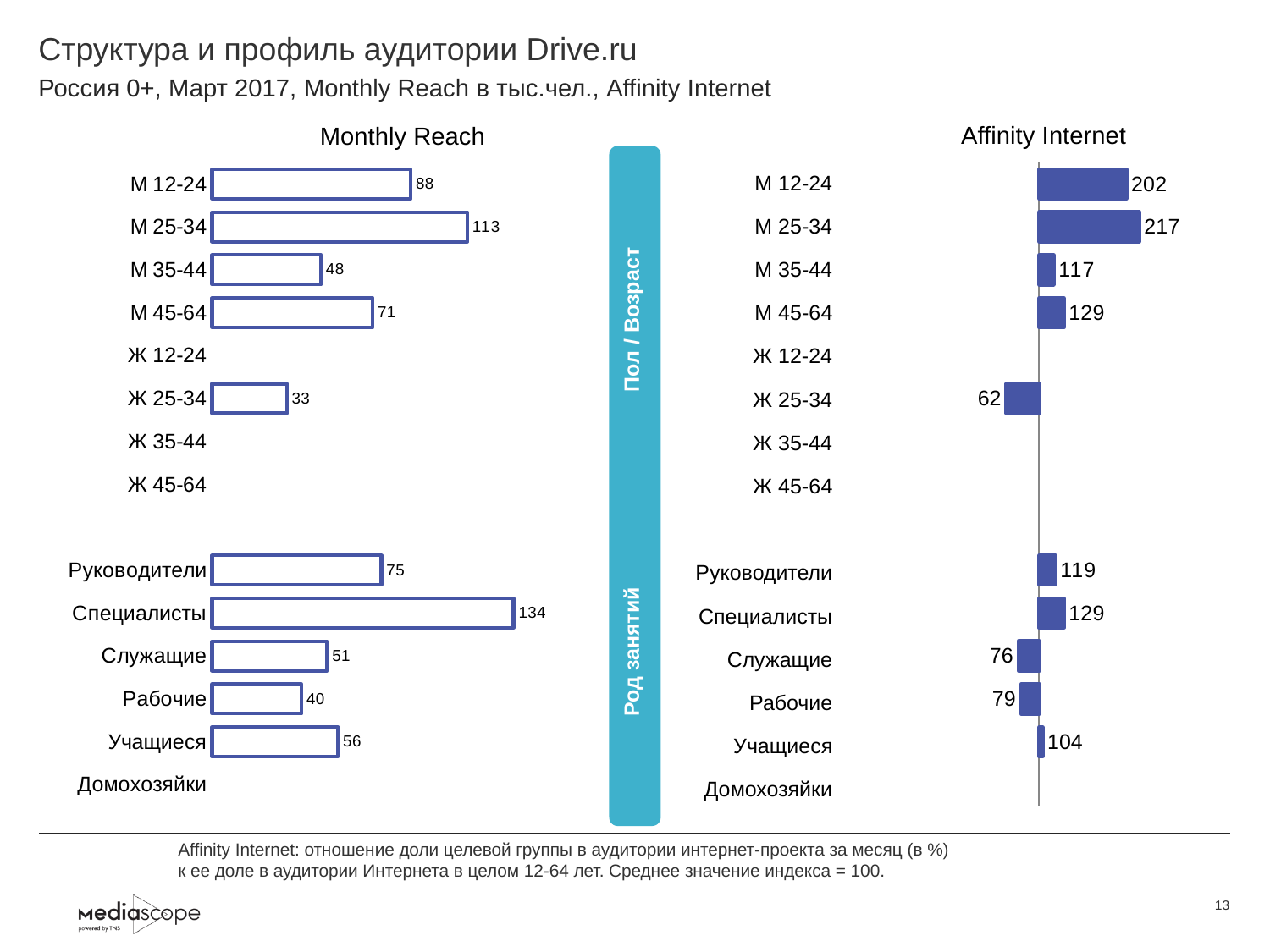
In the Affinity Internet chart, what is the value for Учащиеся? 104 In the Monthly Reach chart, what is the value for M 25-34? 113 In the Affinity Internet chart, which category has the highest value? M 25-34 In the Monthly Reach chart, which is larger: the value for Руководители or the value for Учащиеся? Руководители In the Affinity Internet chart, what is the value for Ж 25-34? 62 In the Monthly Reach chart, which labelled category has the lowest value? Ж 25-34 In the Affinity Internet chart, what is the difference between the values for M 12-24 and M 45-64? 73 In the Monthly Reach chart, what is the value for Специалисты? 134 What kind of chart is the Monthly Reach chart? Bar chart In the Affinity Internet chart, what is the value for M 35-44? 117 In the Monthly Reach chart, what is the difference between the values for M 12-24 and M 35-44? 40 In the Affinity Internet chart, which is larger: the value for Служащие or the value for Рабочие? Рабочие